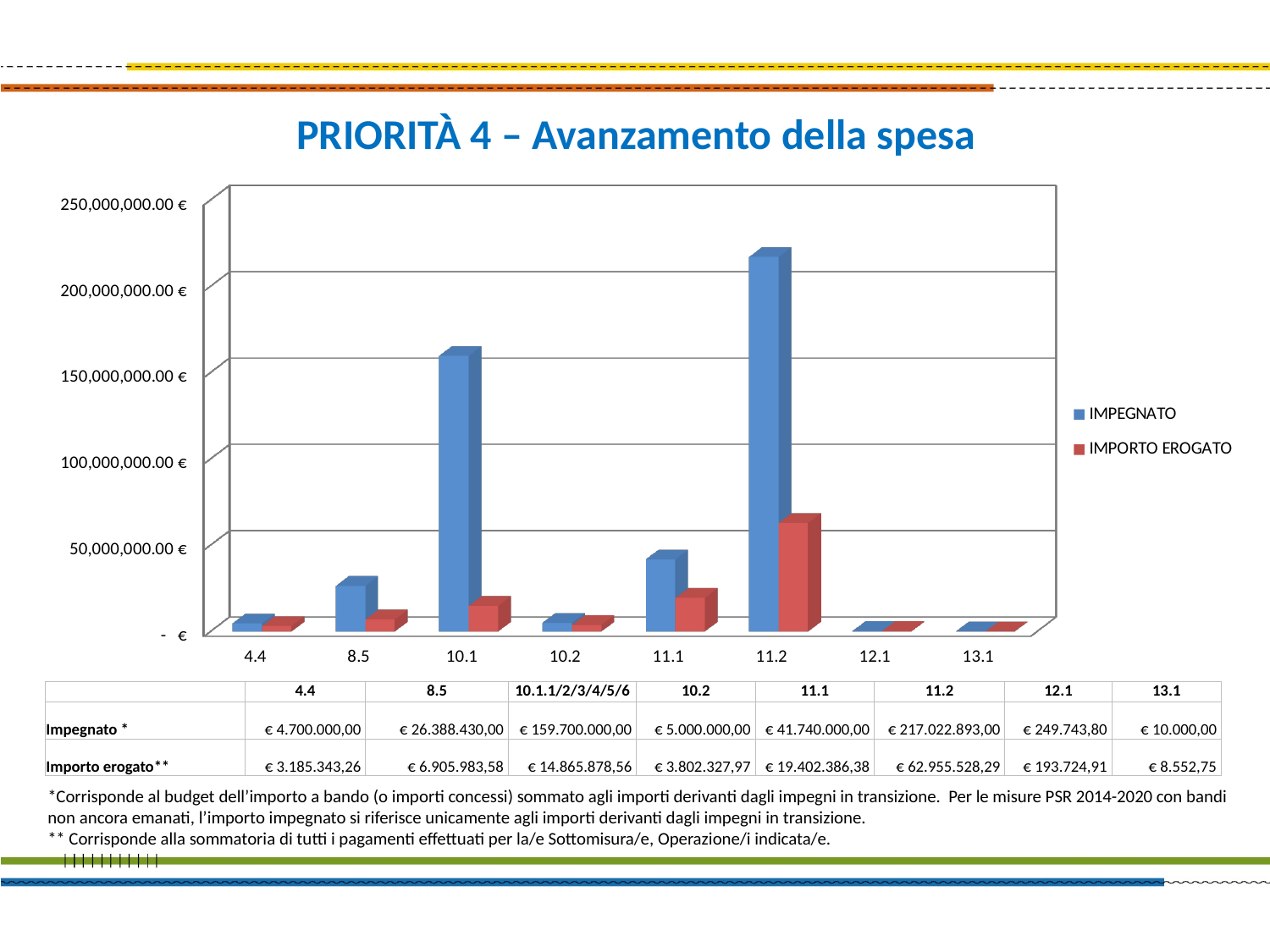
Which is larger, the IMPEGNATO value for 8.5 or for 11.1? 11.1 What is the difference between IMPEGNATO and IMPORTO EROGATO for category 11.2? € 154.067.364,71 What is the IMPEGNATO value for category 11.2? € 217.022.893,00 How many series does the legend list? 2 How many categories are shown on the x axis of the chart? 8 Is the IMPEGNATO value for 10.1 greater or less than 150,000,000.00 €? greater What is the title of the chart? PRIORITÀ 4 – Avanzamento della spesa Which category has the lowest IMPORTO EROGATO value? 13.1 What is the IMPORTO EROGATO value for category 10.1? € 14.865.878,56 What kind of chart is shown on the slide? bar chart Which category has the highest IMPEGNATO value? 11.2 What is the IMPEGNATO value for category 8.5? € 26.388.430,00